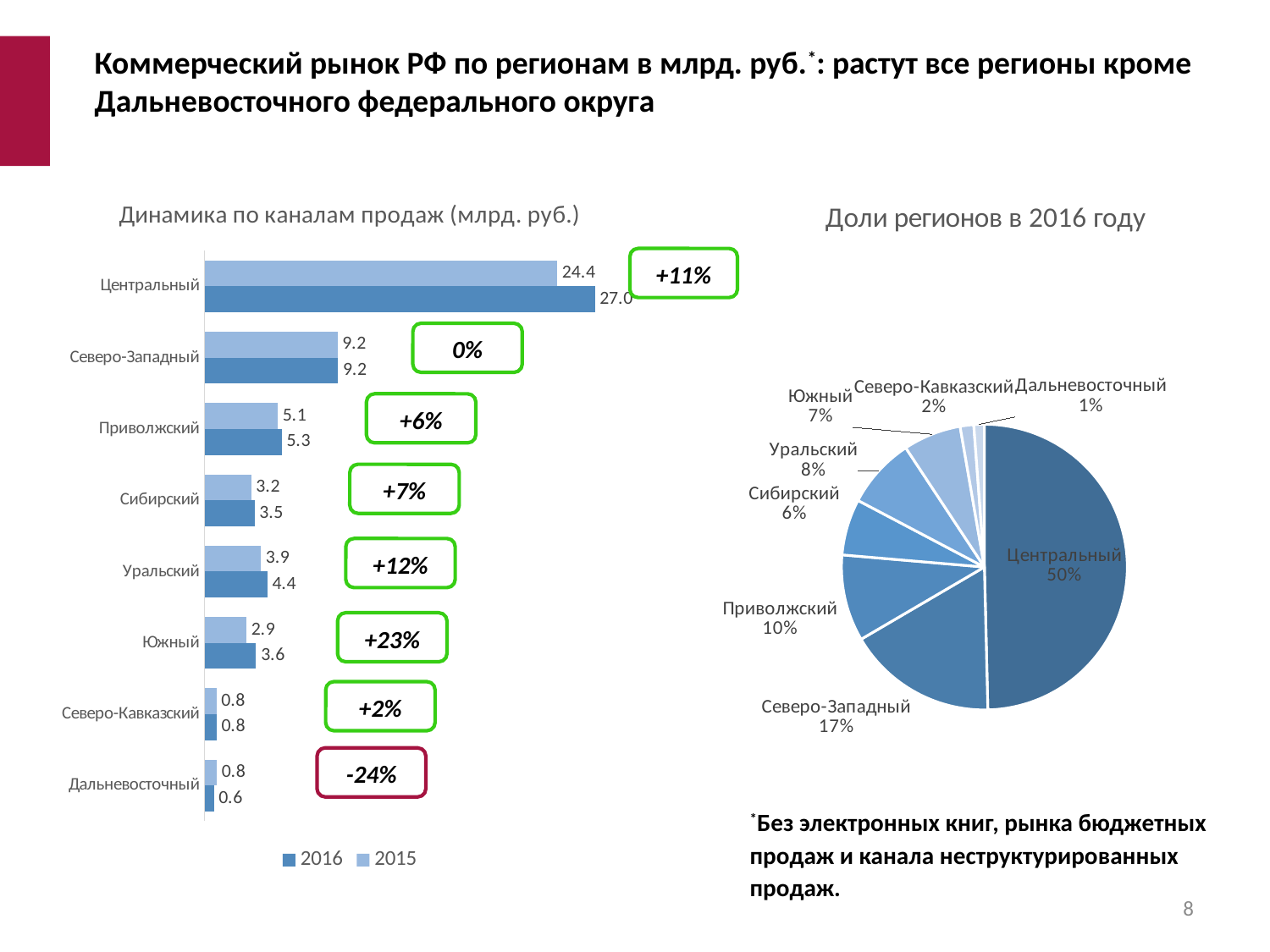
What kind of chart is 'Динамика по каналам продаж (млрд. руб.)'? Bar chart In the chart 'Динамика по каналам продаж (млрд. руб.)', which region has the highest 2016 value? Центральный In the chart 'Динамика по каналам продаж (млрд. руб.)', which is larger for Дальневосточный: the 2016 value or the 2015 value? 2015 In the chart 'Динамика по каналам продаж (млрд. руб.)', what is the difference between the 2016 and 2015 values for Южный? 0.7 In the chart 'Динамика по каналам продаж (млрд. руб.)', which region has the lowest 2016 value? Дальневосточный In the chart 'Динамика по каналам продаж (млрд. руб.)', what is the 2016 value for Центральный? 27.0 How many series does the legend of the chart 'Динамика по каналам продаж (млрд. руб.)' list? 2 In the pie chart 'Доли регионов в 2016 году', what share does Северо-Западный have? 17% What kind of chart is 'Доли регионов в 2016 году'? Pie chart In the pie chart 'Доли регионов в 2016 году', which region has the smallest share? Дальневосточный In the chart 'Динамика по каналам продаж (млрд. руб.)', what is the 2015 value for Уральский? 3.9 How many regions are shown in the chart 'Динамика по каналам продаж (млрд. руб.)'? 8